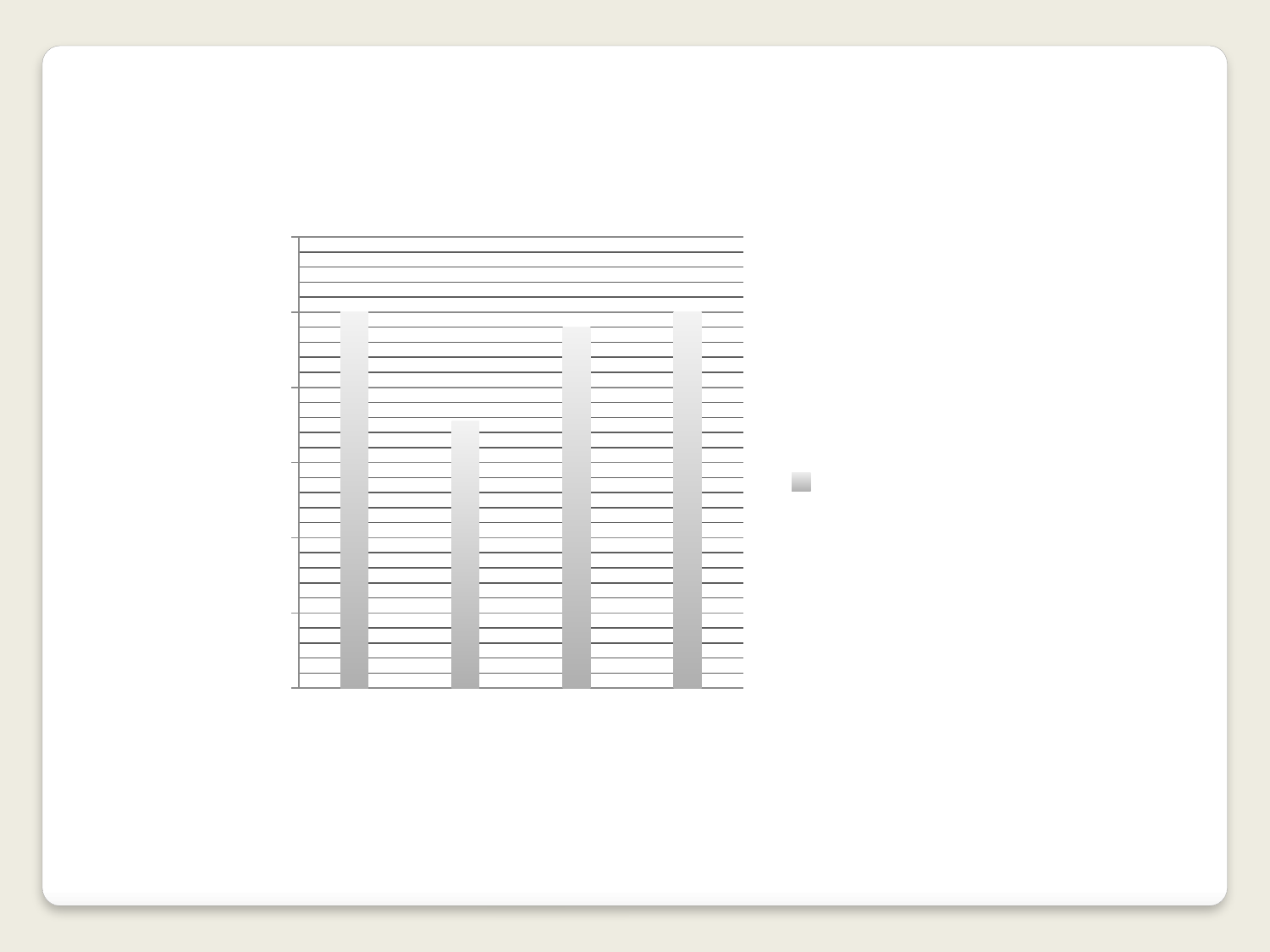
What kind of chart is shown on the slide? bar chart Which bar is the lowest in the chart, counting from the left? the second bar Is the third bar from the left taller or shorter than the second bar from the left? taller How many bars are plotted in the chart? 4 How many series does the legend list? 1 Is the first bar from the left taller or shorter than the second bar from the left? taller